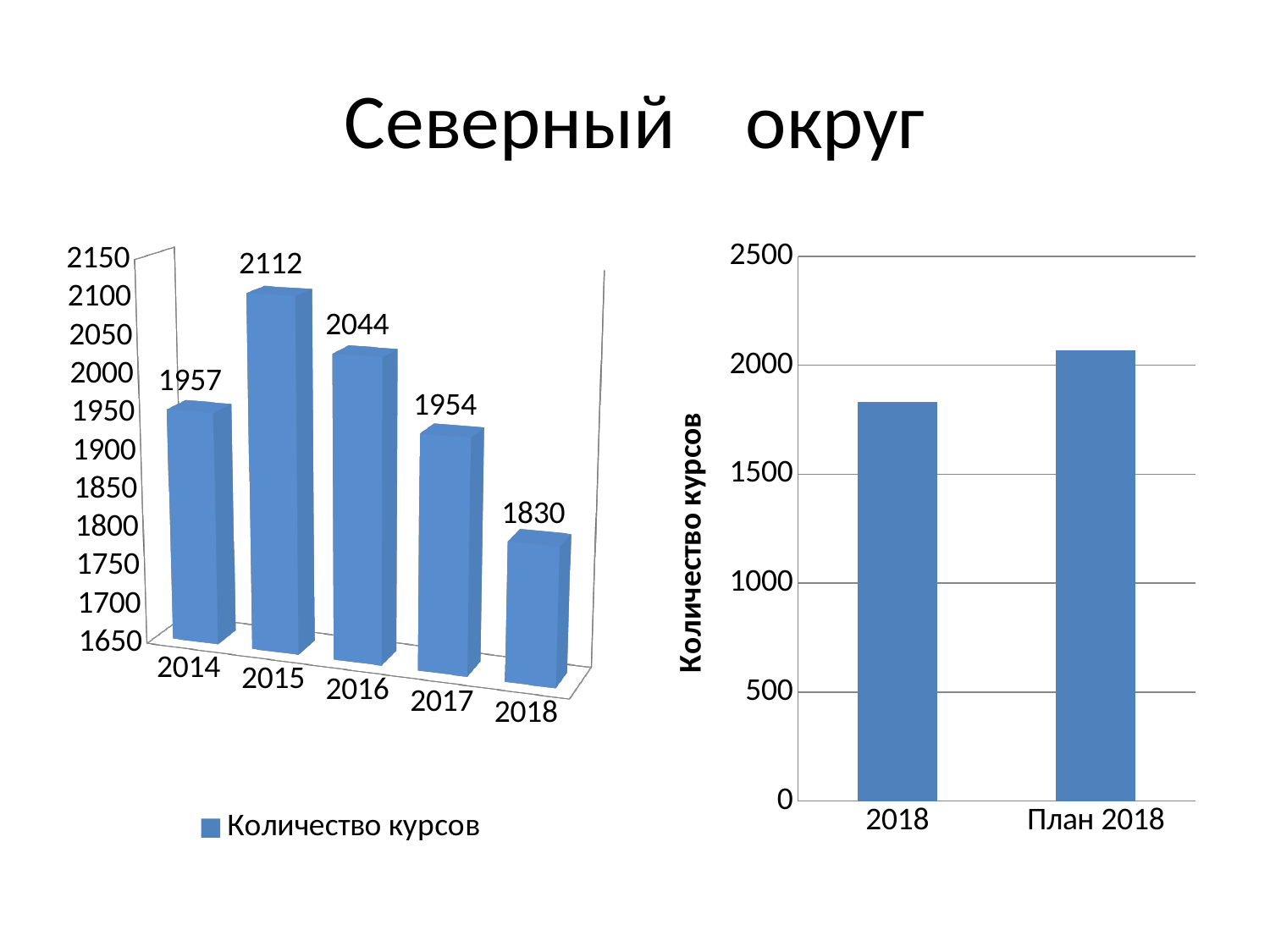
On the left chart, what kind of chart is it? bar chart On the left chart, which is larger, the value for 2016 or the value for 2017? 2016 On the left chart, what is the value for 2018? 1830 On the left chart, what series name does the legend show? Количество курсов On the right chart, is the value for 2018 greater or less than 2000? less On the left chart, what is the value for 2015? 2112 On the left chart, which year has the highest value? 2015 On the left chart, how many years are shown on the x axis? 5 On the right chart, is the value for План 2018 greater or less than 2000? greater On the left chart, do the values rise or fall from 2016 to 2018? fall On the left chart, which year has the lowest value? 2018 On the left chart, what is the difference between the values for 2015 and 2018? 282